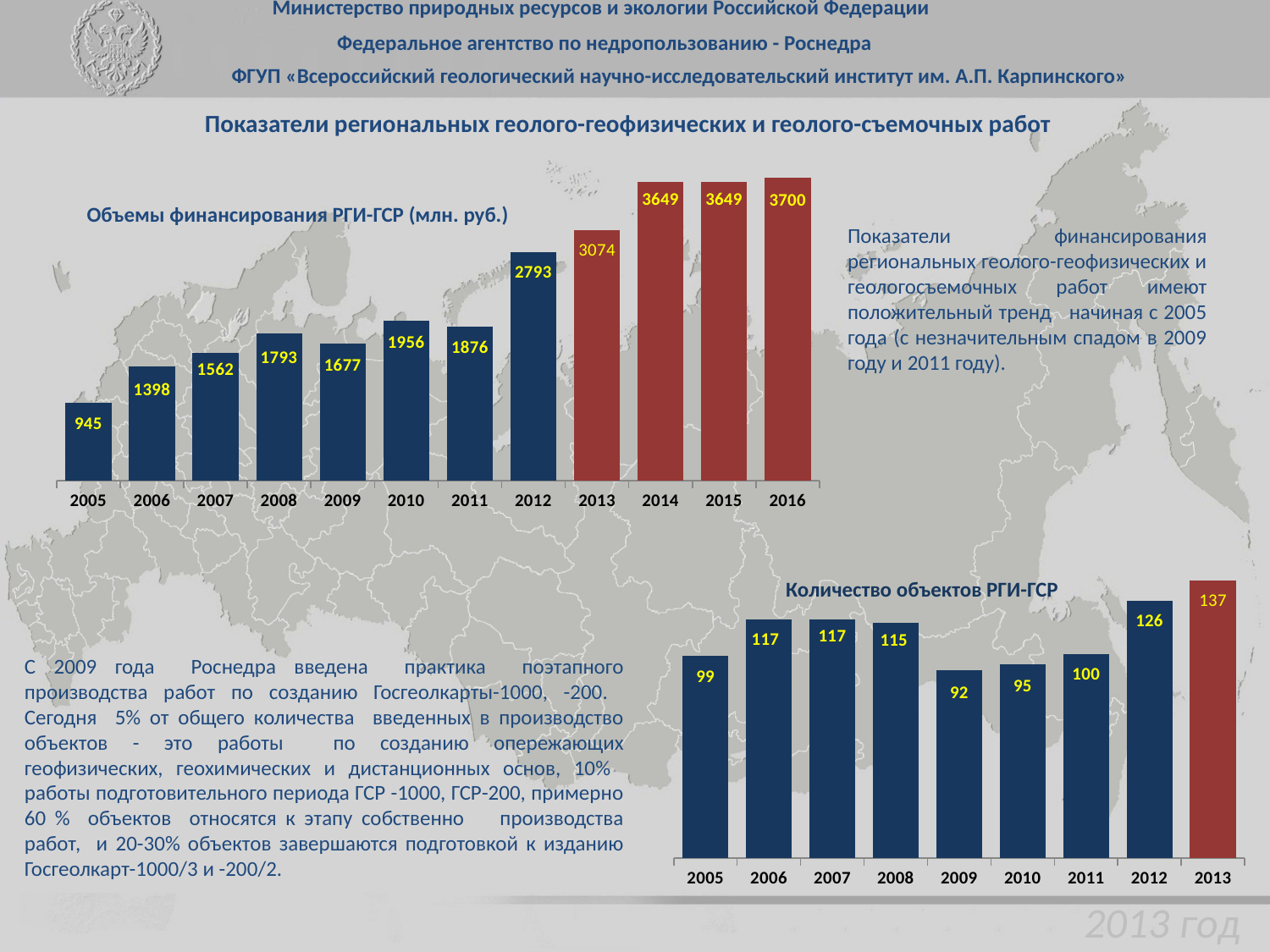
How many years are shown in the chart 'Количество объектов РГИ-ГСР'? 9 In the chart 'Количество объектов РГИ-ГСР', what colour is the bar for 2013? red In the chart 'Объемы финансирования РГИ-ГСР (млн. руб.)', what is the value for 2012? 2793 In the chart 'Объемы финансирования РГИ-ГСР (млн. руб.)', what is the difference between the values for 2013 and 2012? 281 In the chart 'Количество объектов РГИ-ГСР', which year has the lowest value? 2009 In the chart 'Объемы финансирования РГИ-ГСР (млн. руб.)', what is the value for 2005? 945 In the chart 'Количество объектов РГИ-ГСР', what is the difference between the values for 2013 and 2012? 11 What type of chart is 'Количество объектов РГИ-ГСР'? bar chart How many years are shown in the chart 'Объемы финансирования РГИ-ГСР (млн. руб.)'? 12 In the chart 'Количество объектов РГИ-ГСР', what is the value for 2009? 92 In the chart 'Объемы финансирования РГИ-ГСР (млн. руб.)', which year has the highest value? 2016 In the chart 'Объемы финансирования РГИ-ГСР (млн. руб.)', which is larger, the value for 2009 or the value for 2008? 2008